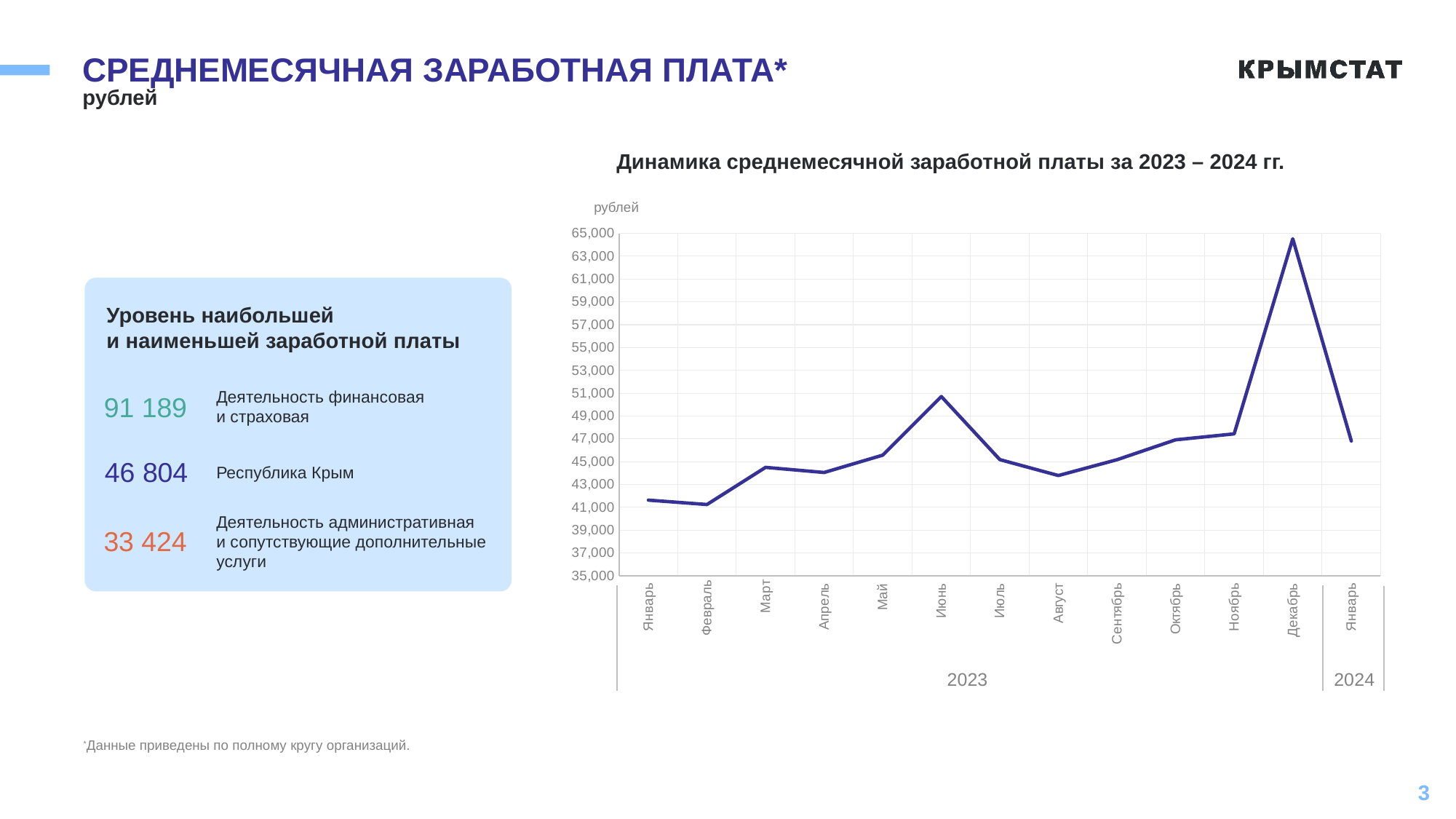
Does the line rise or fall from Ноябрь 2023 to Декабрь 2023? rise Is the value for Январь 2023 greater or less than 43,000? less What kind of chart is shown on the slide? line chart Which is larger, the value for Июнь 2023 or Июль 2023? Июнь 2023 Is the value for Сентябрь 2023 greater or less than 47,000? less Is the value for Июнь 2023 greater or less than 49,000? greater Which is larger, the value for Декабрь 2023 or Январь 2024? Декабрь 2023 What is the title of the chart? Динамика среднемесячной заработной платы за 2023 – 2024 гг. In which month is the average monthly wage highest on the chart? Декабрь 2023 How many monthly data points are plotted on the chart? 13